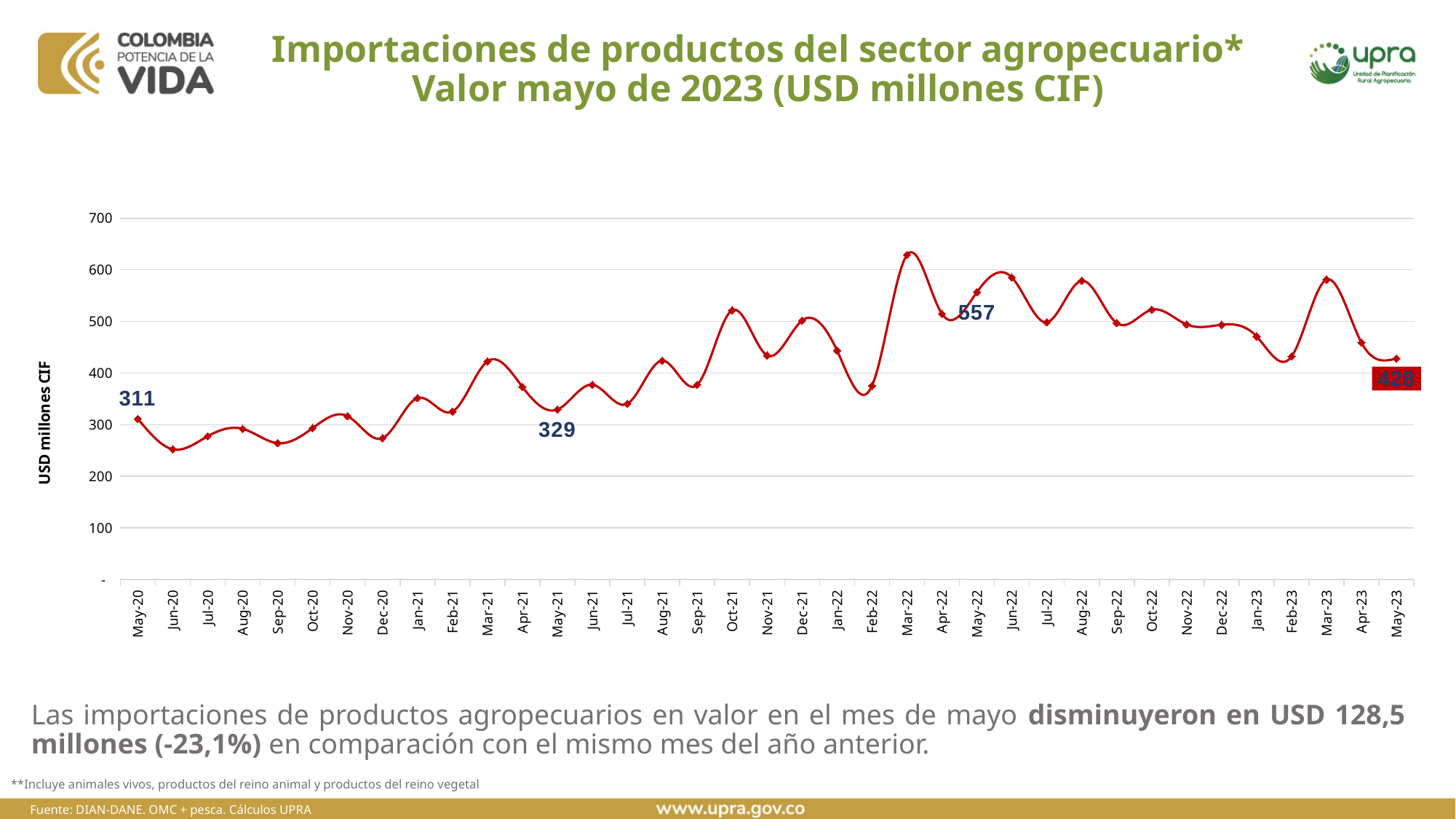
What is the difference between the values for May-22 and May-23? 129 Is the value for Oct-21 greater or less than 500? greater Is the value for Jun-20 greater or less than 300? less What is the label on the vertical axis of the chart? USD millones CIF What is the value for May-22? 557 What is the value for May-23? 428 Which is larger, the value for May-22 or the value for May-23? May-22 What is the value for May-21? 329 Which month has the highest value on the chart? Mar-22 What kind of chart is shown on the slide? line chart What is the value for May-20? 311 How many monthly data points are plotted on the chart? 37